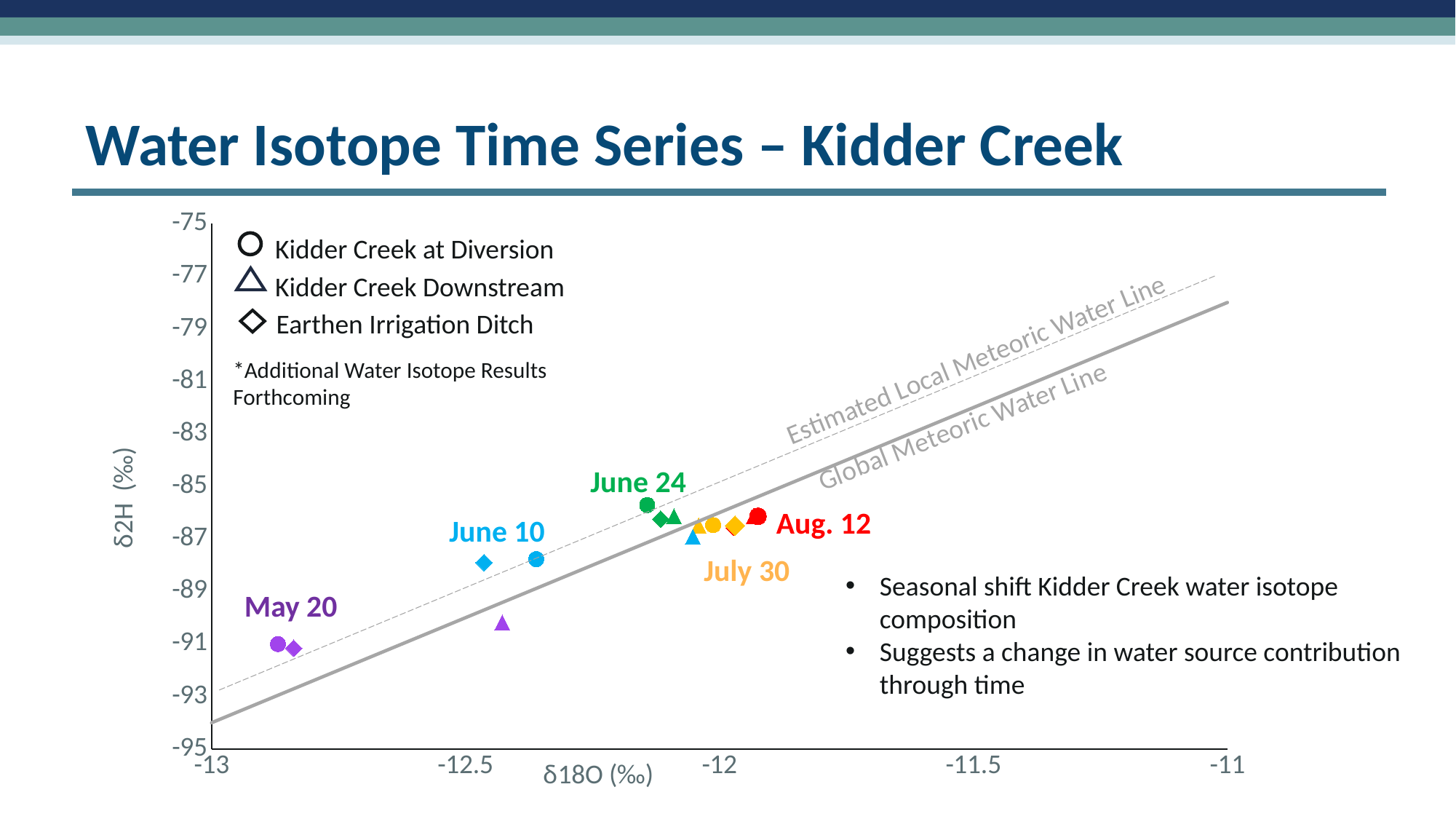
What kind of chart is shown on the slide? Scatter chart Do the δ18O values of the Kidder Creek at Diversion samples rise or fall from May 20 to Aug. 12? rise Which has the larger δ18O value, the May 20 or the June 10 Kidder Creek at Diversion sample? June 10 Is the δ18O value for the Aug. 12 Kidder Creek at Diversion sample greater or less than -12? greater Is the δ18O value for the May 20 Kidder Creek at Diversion sample greater or less than -12.5? less Is the δ2H value for the May 20 Kidder Creek Downstream sample greater or less than -89? less Which marker shape represents the Earthen Irrigation Ditch series? Diamond How many sampling dates are labelled on the chart? 5 What is the label on the x axis of the chart? δ18O (‰) Which sampling date has the lowest δ2H value? May 20 How many series does the legend list? 3